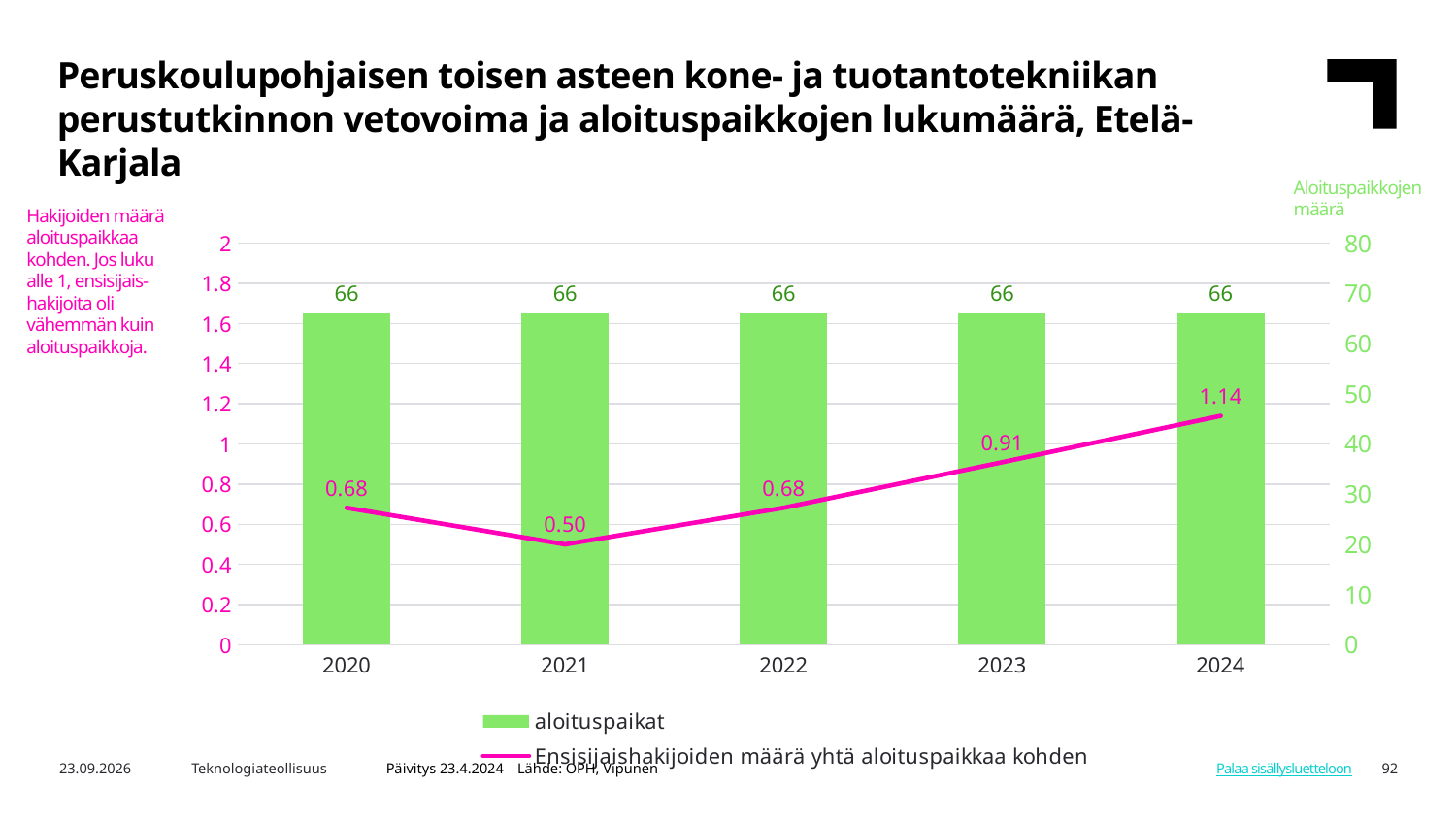
Does the line series rise or fall from 2021 to 2024? rise In which year is the line series 'Ensisijaishakijoiden määrä yhtä aloituspaikkaa kohden' highest? 2024 What kind of chart is shown on the slide? Combined bar and line chart How many years are shown on the x axis? 5 How many 'aloituspaikat' are shown for 2022? 66 Which year has a larger value on the line series: 2022 or 2023? 2023 What is the difference between the line values for 2024 and 2023? 0.23 What is the value of the line series 'Ensisijaishakijoiden määrä yhtä aloituspaikkaa kohden' for 2021? 0.50 Is the line value for 2023 greater or less than 1? less What is the value of the line series 'Ensisijaishakijoiden määrä yhtä aloituspaikkaa kohden' for 2024? 1.14 In which year is the line series 'Ensisijaishakijoiden määrä yhtä aloituspaikkaa kohden' lowest? 2021 How many series does the legend list? 2